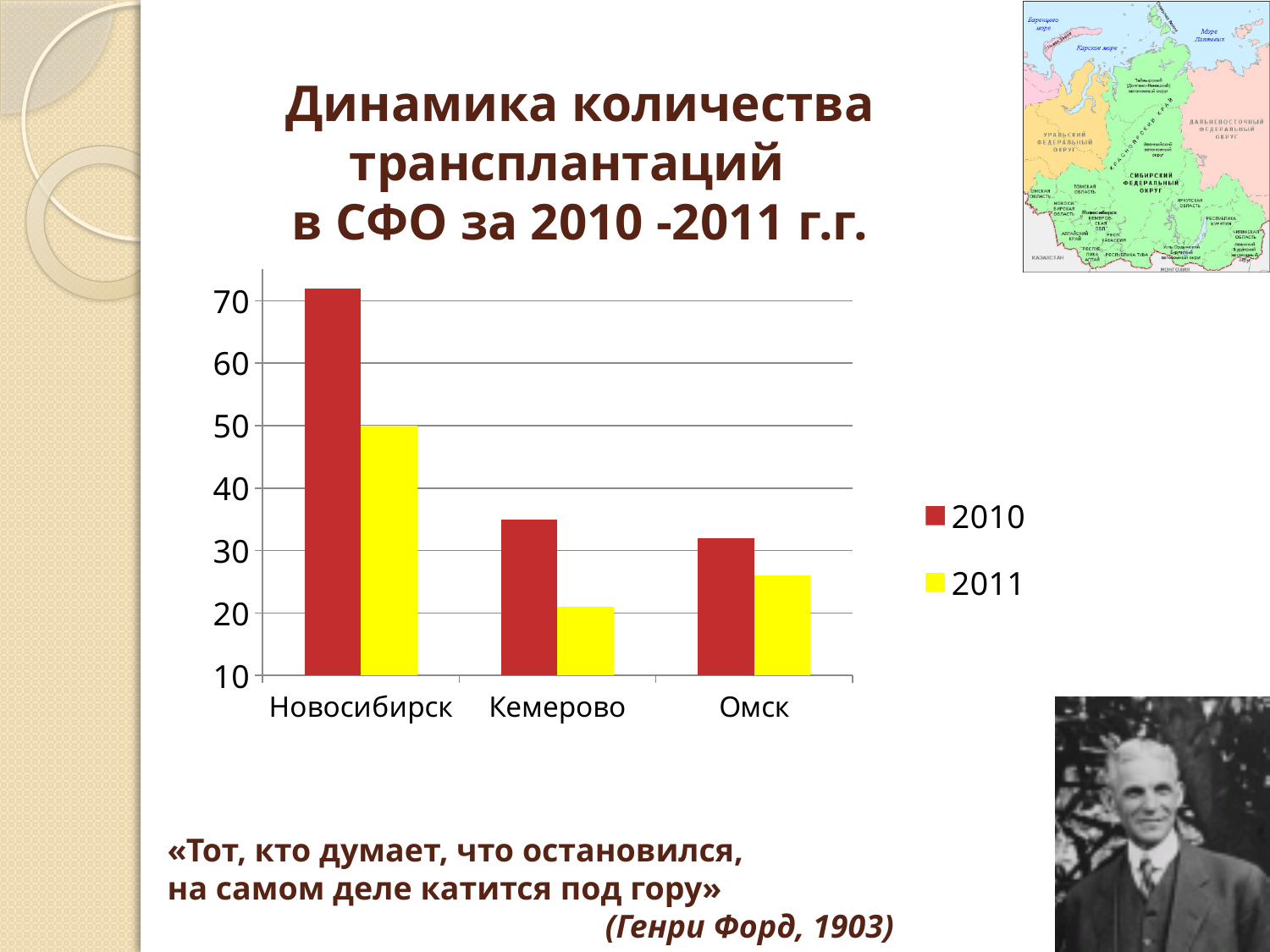
Do the 2010 values rise or fall from Новосибирск to Омск along the x axis? fall Is the 2010 value for Новосибирск greater or less than 70? greater Is the 2010 value for Омск greater or less than 30? greater How many series does the legend list? 2 Which city has the highest value for 2010? Новосибирск Which is larger: the 2011 value for Омск or the 2011 value for Кемерово? Омск Is the 2011 value for Кемерово greater or less than 30? less How many cities are shown on the x axis? 3 Which city has the lowest value for 2011? Кемерово What kind of chart is shown on the slide? bar chart Which colour represents the 2011 series in the legend? yellow